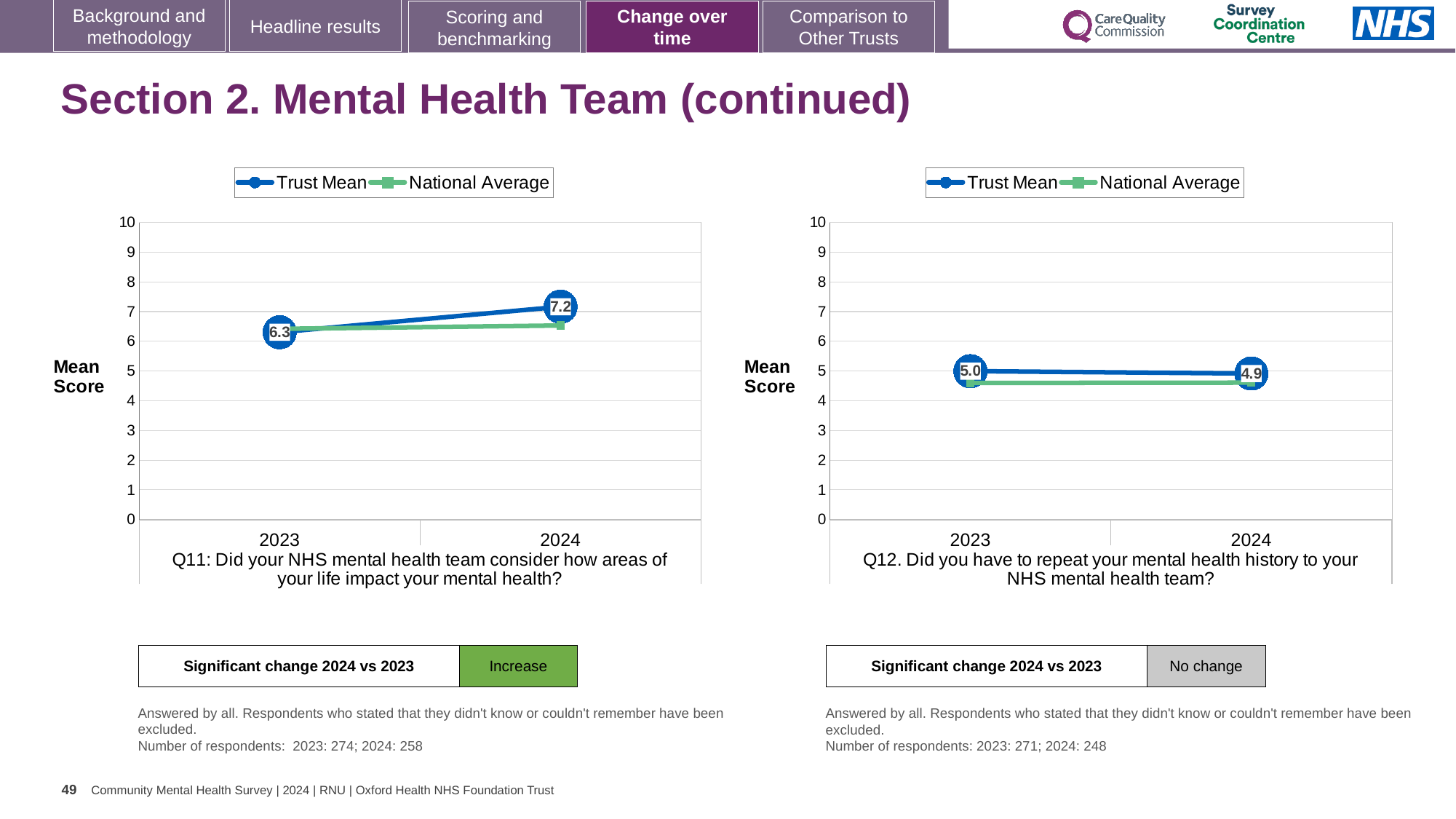
In the right chart (Q12), what is the Trust Mean score for 2024? 4.9 In the left chart (Q11), what is the Trust Mean score for 2024? 7.2 In the left chart (Q11), what is the Trust Mean score for 2023? 6.3 In the right chart (Q12), what is the difference between the Trust Mean in 2023 and 2024? 0.1 In the right chart (Q12), is the National Average for 2023 greater or less than 5? less How many series does the legend of the right chart (Q12) list? 2 In the left chart (Q11), by how much did the Trust Mean change from 2023 to 2024? 0.9 In the left chart (Q11), is the National Average for 2024 greater or less than 7? less In the left chart (Q11), which series is higher in 2024, Trust Mean or National Average? Trust Mean What kind of chart is the left chart (Q11)? line chart In the right chart (Q12), what is the Trust Mean score for 2023? 5.0 In the left chart (Q11), does the Trust Mean rise or fall from 2023 to 2024? rise